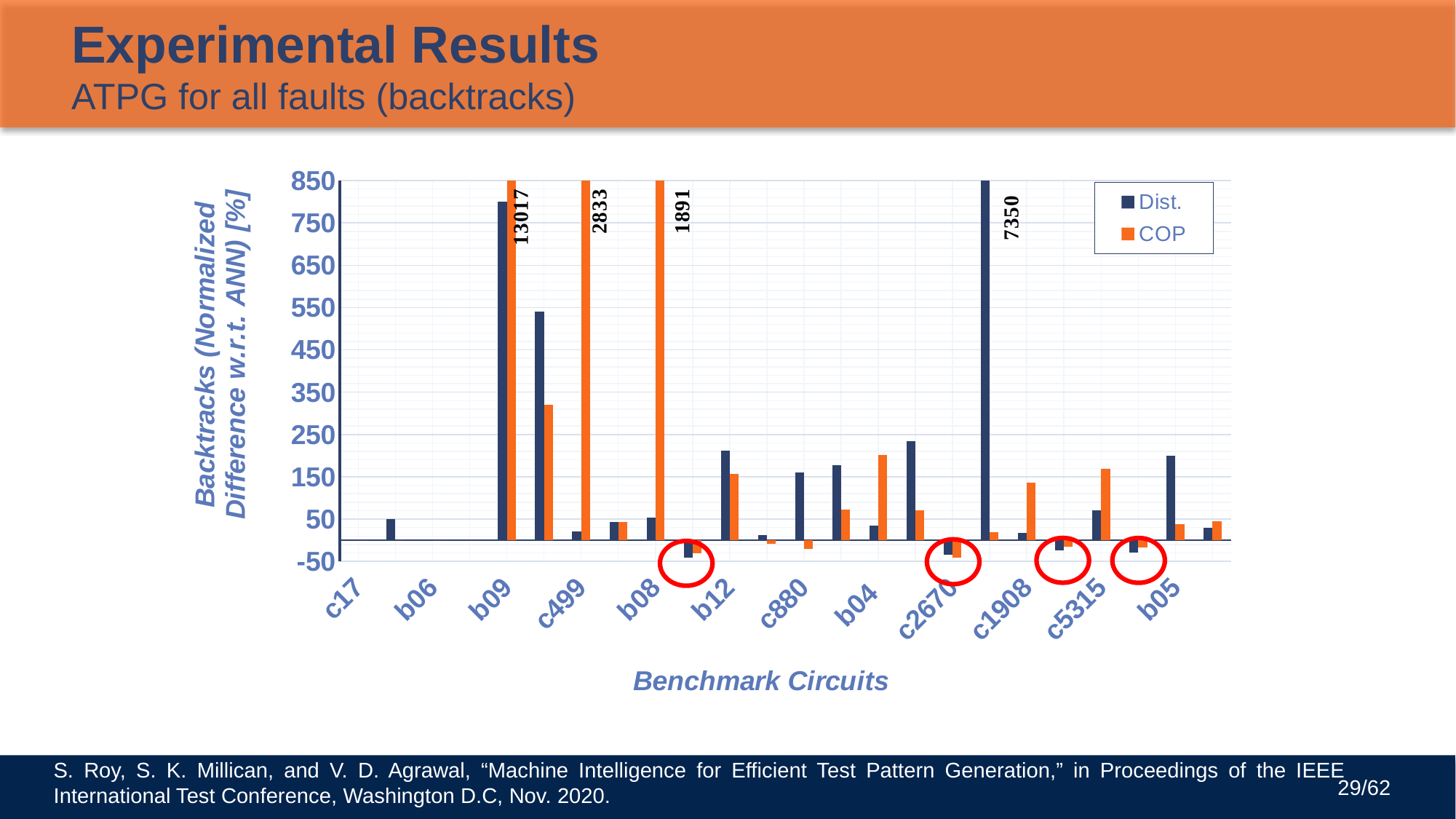
How many series does the legend list? 2 Which is larger, the COP value for c499 or the COP value for b08? c499 How many benchmark circuit labels are shown on the x axis? 12 Which series does the bar labelled 7350 belong to? Dist. What is the difference between the COP value for c499 (2833) and the COP value for b08 (1891)? 942 What are the two series named in the legend? Dist. and COP What is the COP value labelled for c499? 2833 What is the title of the vertical axis? Backtracks (Normalized Difference w.r.t. ANN) [%] What kind of chart is shown on the slide? bar chart What is the largest value printed as a data label on the chart? 13017 What is the COP value labelled for b08? 1891 What is the COP value labelled for b09? 13017